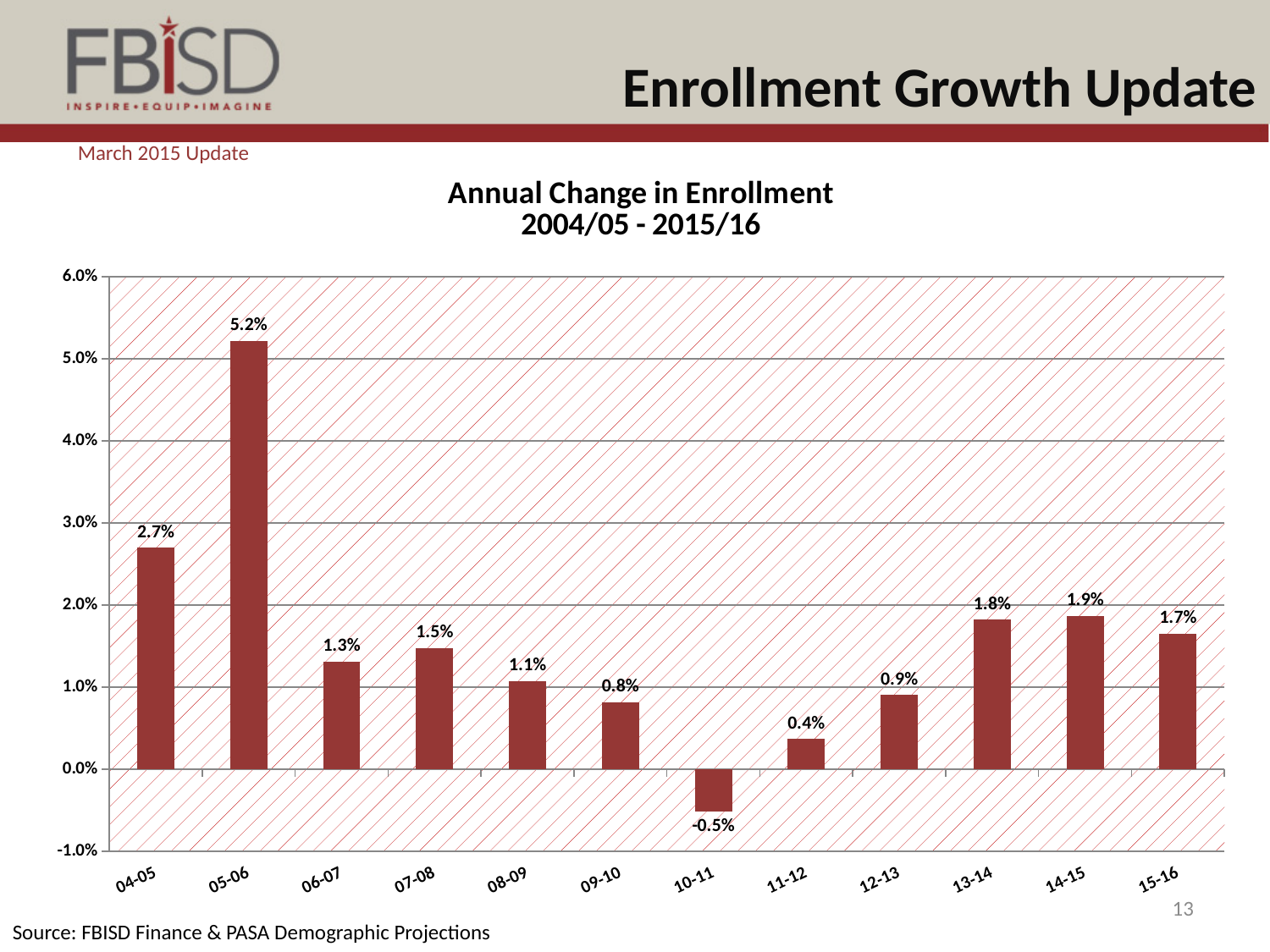
Is the value for 13-14 greater or less than 1.0%? greater Which year has a larger annual change in enrollment, 07-08 or 08-09? 07-08 What is the annual change in enrollment for 14-15? 1.9% How many years are shown on the x axis of the chart? 12 What is the title of the chart? Annual Change in Enrollment 2004/05 - 2015/16 Which year has the highest annual change in enrollment? 05-06 Which year has the lowest annual change in enrollment? 10-11 What is the annual change in enrollment for 10-11? -0.5% What kind of chart is shown on the slide? Bar chart What is the difference between the annual change in enrollment for 05-06 and 04-05? 2.5% Do the values rise or fall from 05-06 to 10-11? Fall What is the annual change in enrollment for 05-06? 5.2%